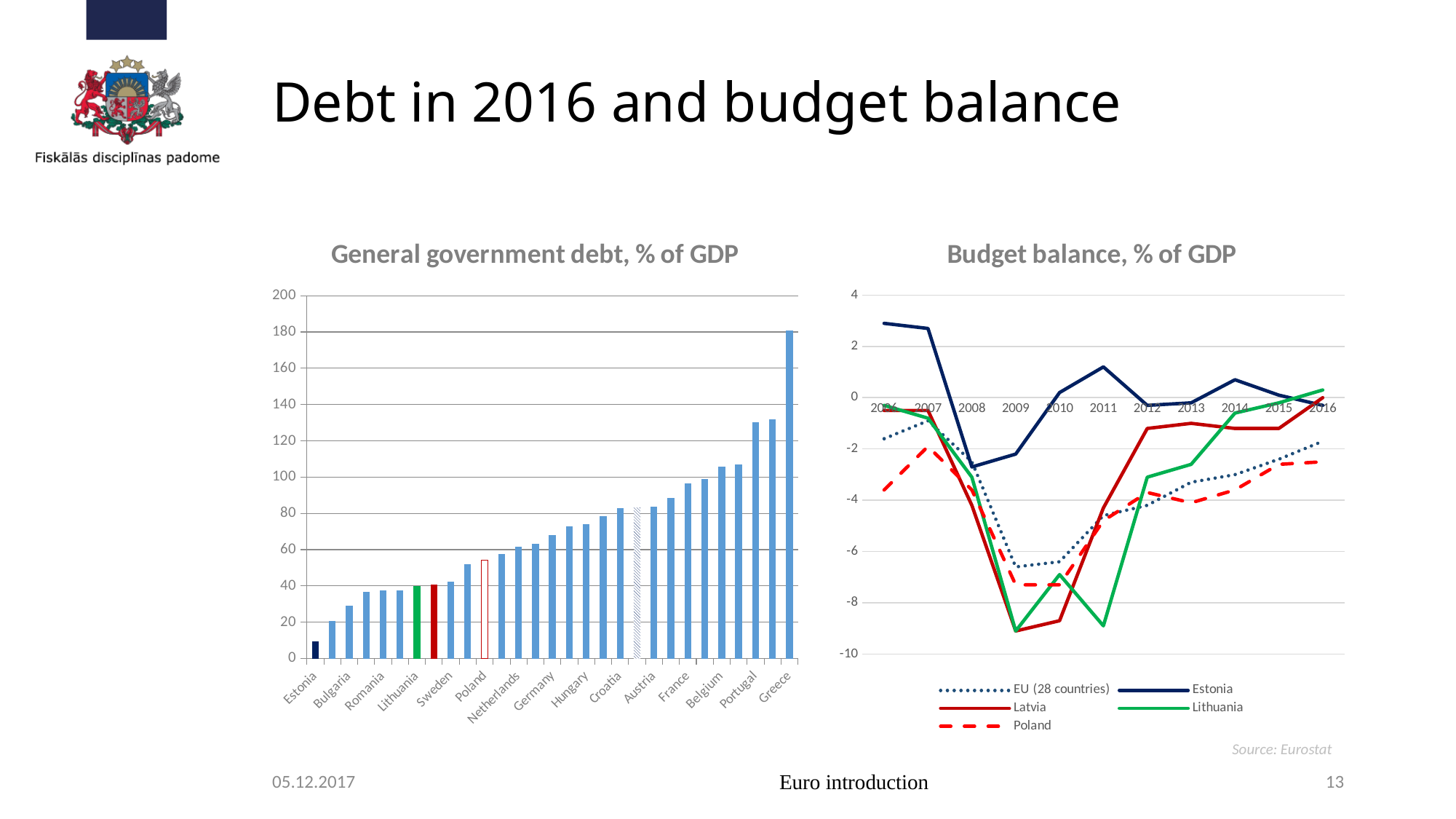
In the 'General government debt, % of GDP' chart, which country has the highest debt? Greece How many years are shown on the x axis of the 'Budget balance, % of GDP' chart? 11 In the 'General government debt, % of GDP' chart, which country has the lowest debt? Estonia What kind of chart is the 'Budget balance, % of GDP' chart? line chart In the 'General government debt, % of GDP' chart, is the value for Greece greater or less than 160? greater In the 'General government debt, % of GDP' chart, which has the larger value, Portugal or Bulgaria? Portugal How many series does the legend of the 'Budget balance, % of GDP' chart list? 5 In the 'Budget balance, % of GDP' chart, which series has the highest value in 2006? Estonia What source is cited for the charts on the slide? Eurostat In the 'Budget balance, % of GDP' chart, is the value for Lithuania in 2011 greater or less than -8? less In the 'General government debt, % of GDP' chart, is the value for Estonia greater or less than 20? less What kind of chart is the 'General government debt, % of GDP' chart? bar chart